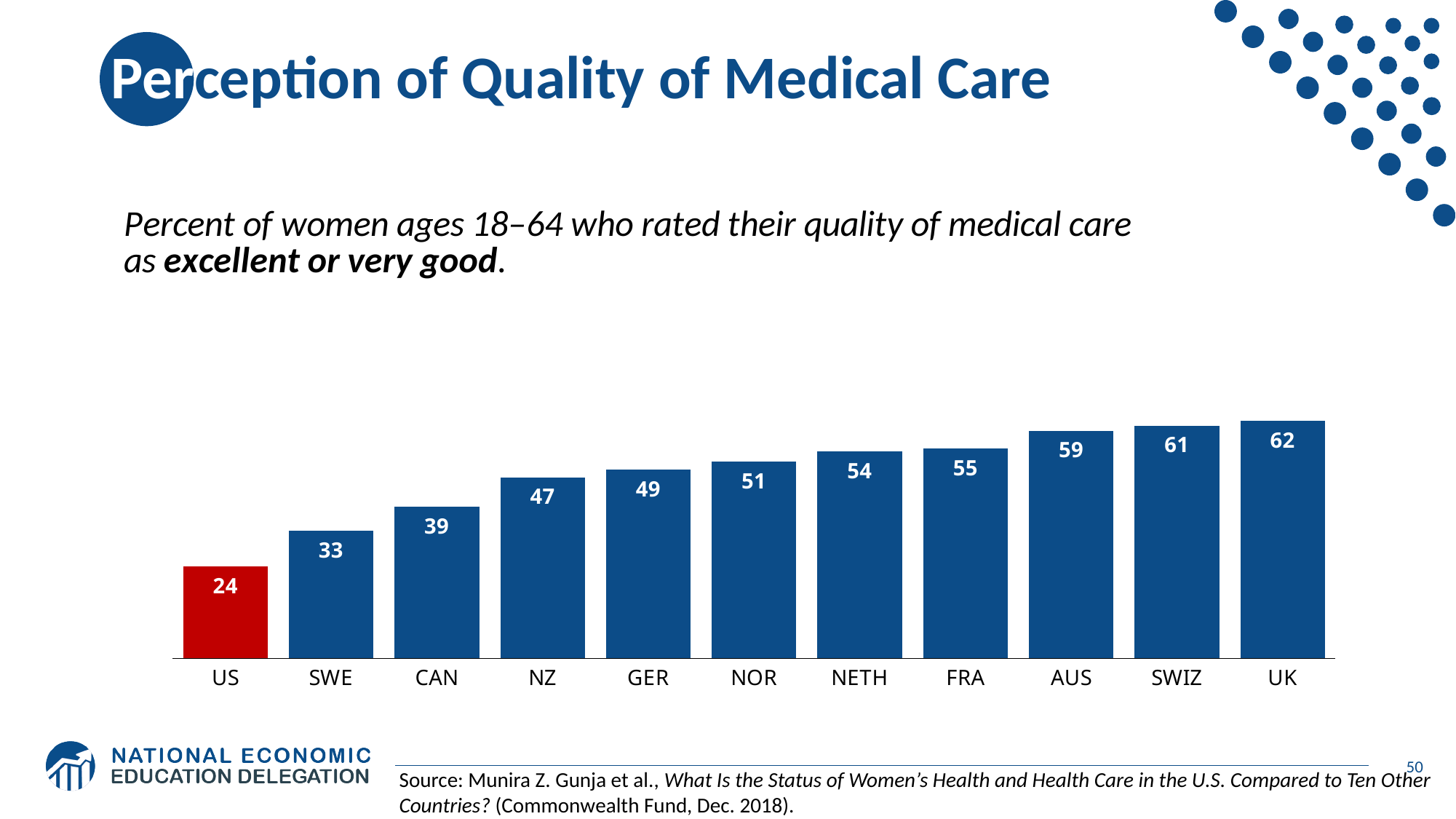
How many countries are shown in the chart? 11 What is the difference between the values for NETH and CAN? 15 What kind of chart is shown on the slide? bar chart What is the value for AUS? 59 What is the difference between the values for UK and US? 38 Which bar is coloured red rather than blue? US What is the value for the US? 24 Which is larger, the value for SWE or the value for NZ? NZ What is the value for GER? 49 Which country has the lowest value? US Which country has the highest value? UK Do the values rise or fall from left to right along the x axis? rise